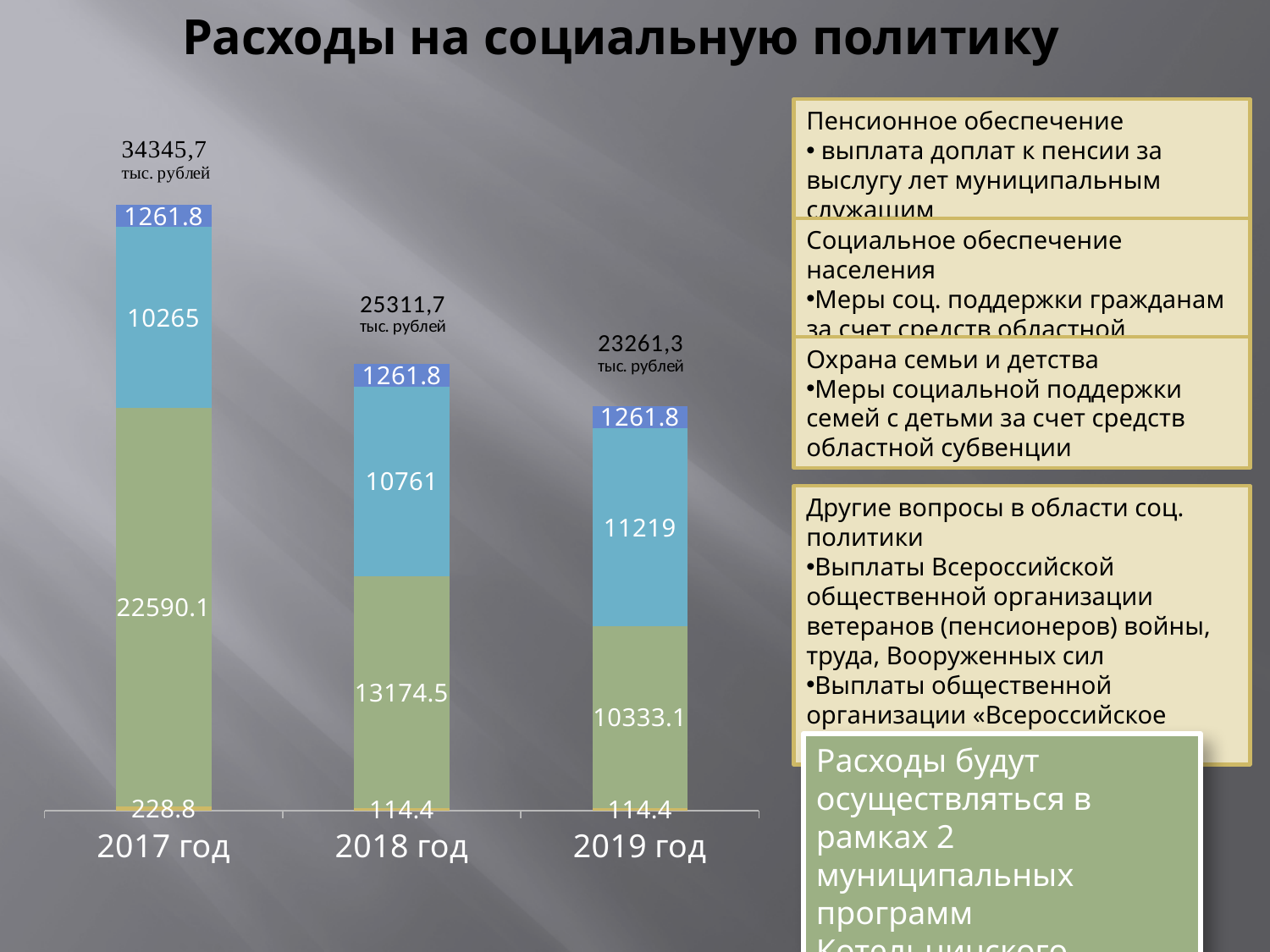
Do the total values rise or fall from 2017 год to 2019 год? Fall What is the value of the blue segment of the bar for 2019 год? 11219 Which year has the highest total expenditure? 2017 год What is the difference between the green segment for 2017 год (22590.1) and the green segment for 2018 год (13174.5)? 9415.6 What is the title of the slide containing the chart? Расходы на социальную политику How many years (categories) are shown on the x axis of the chart? 3 What is the value of the bottom segment of the bar for 2017 год? 228.8 Which year has the lowest total expenditure? 2019 год What kind of chart is shown on the slide? Stacked bar chart Which is larger: the blue segment for 2018 год or the blue segment for 2019 год? 2019 год What is the value of the green segment of the bar for 2018 год? 13174.5 What is the total value printed above the bar for 2017 год? 34345,7 тыс. рублей